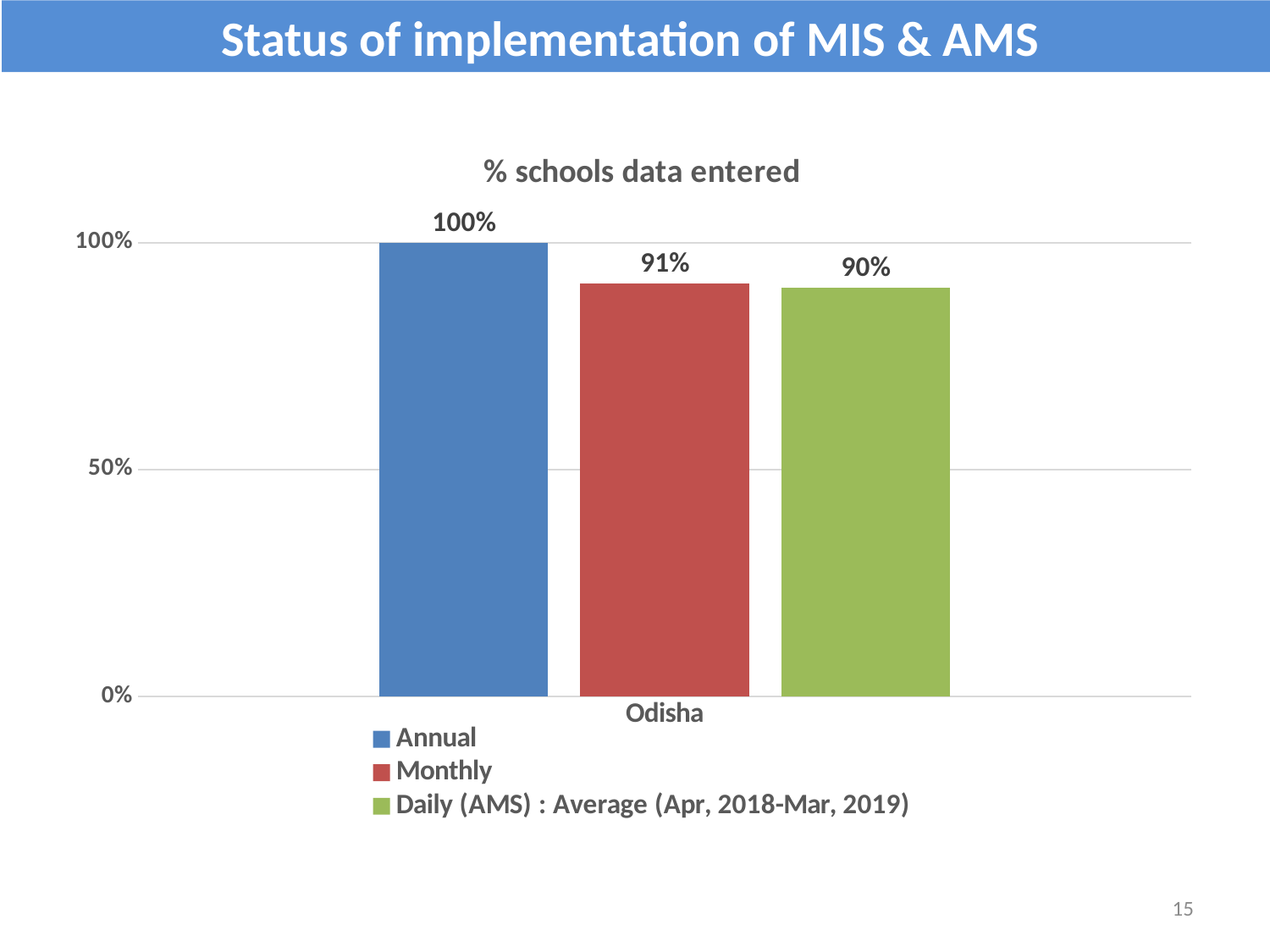
Which series has the lowest value for Odisha? Daily (AMS) : Average (Apr, 2018-Mar, 2019) What is the value of the Daily (AMS) : Average (Apr, 2018-Mar, 2019) series for Odisha? 90% Is the Annual value larger or smaller than the Monthly value? larger How many series does the legend list? 3 How many categories are shown on the x axis? 1 What is the value of the Annual series for Odisha? 100% What is the difference between the Monthly and Daily (AMS) values for Odisha? 1% What is the title of the chart? % schools data entered Which series has the highest value for Odisha? Annual What is the difference between the Annual and Monthly values for Odisha? 9% What is the value of the Monthly series for Odisha? 91% What kind of chart is shown on the slide? bar chart